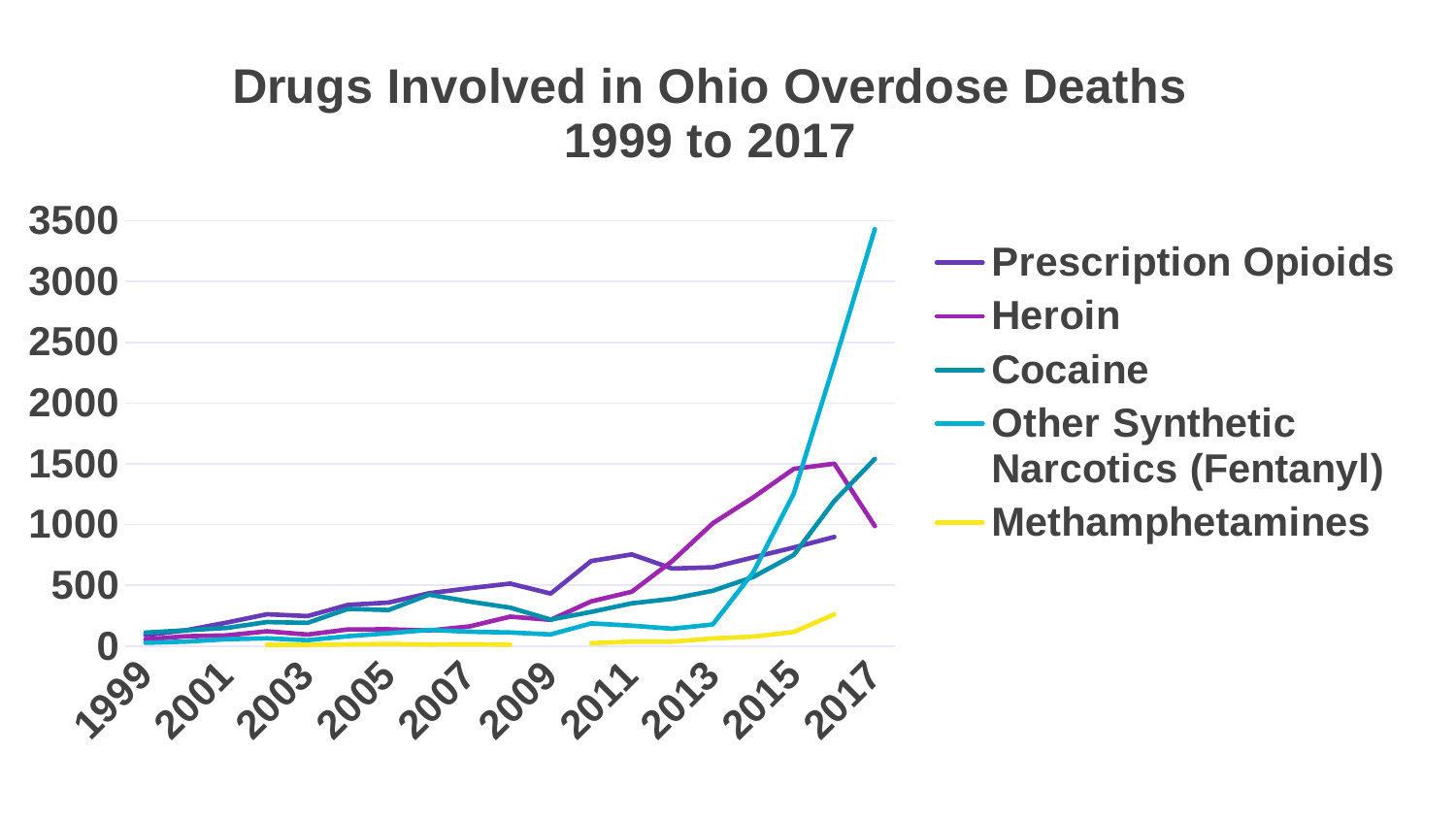
Is the value for Other Synthetic Narcotics (Fentanyl) in 2017 greater or less than 3000? greater Is the value for Other Synthetic Narcotics (Fentanyl) in 2013 greater or less than 500? less In 2014, which is larger: Heroin or Cocaine? Heroin How many series does the legend list? 5 Which drug has the highest number of overdose deaths in 2017? Other Synthetic Narcotics (Fentanyl) Is the value for Cocaine in 2017 greater or less than 1000? greater Does the Other Synthetic Narcotics (Fentanyl) line rise or fall from 2013 to 2017? Rise What is the title of the chart? Drugs Involved in Ohio Overdose Deaths 1999 to 2017 What kind of chart is shown on the slide? Line chart Which drug has the lowest number of overdose deaths in 2017? Heroin